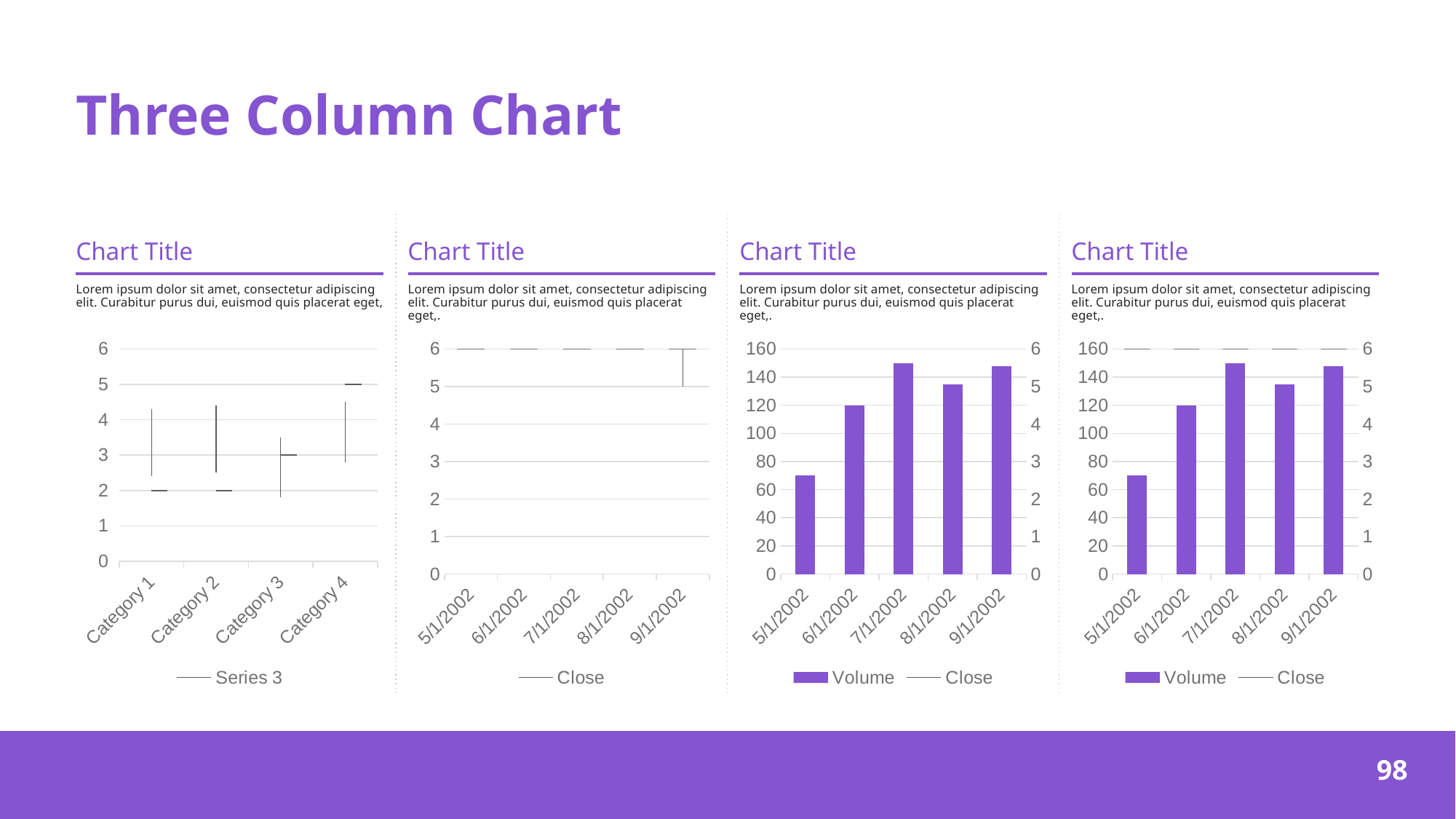
In the third chart from the left, how many series does the legend list? 2 In the rightmost chart, which is larger, the Volume for 5/1/2002 or for 6/1/2002? 6/1/2002 In the second chart from the left, how many dates are shown on the x axis? 5 In the leftmost chart, how many categories are shown on the x axis? 4 In the third chart from the left, is the Volume for 7/1/2002 greater or less than 140? greater In the rightmost chart, is the Volume for 8/1/2002 greater or less than 140? less In the second chart from the left, what series name does the legend show? Close In the third chart from the left, is the Volume for 5/1/2002 greater or less than 80? less In the leftmost chart, what series name does the legend show? Series 3 In the third chart from the left, what kind of chart is used for the Volume series? bar chart In the third chart from the left, which date has the lowest Volume? 5/1/2002 How many charts are on the slide? 4